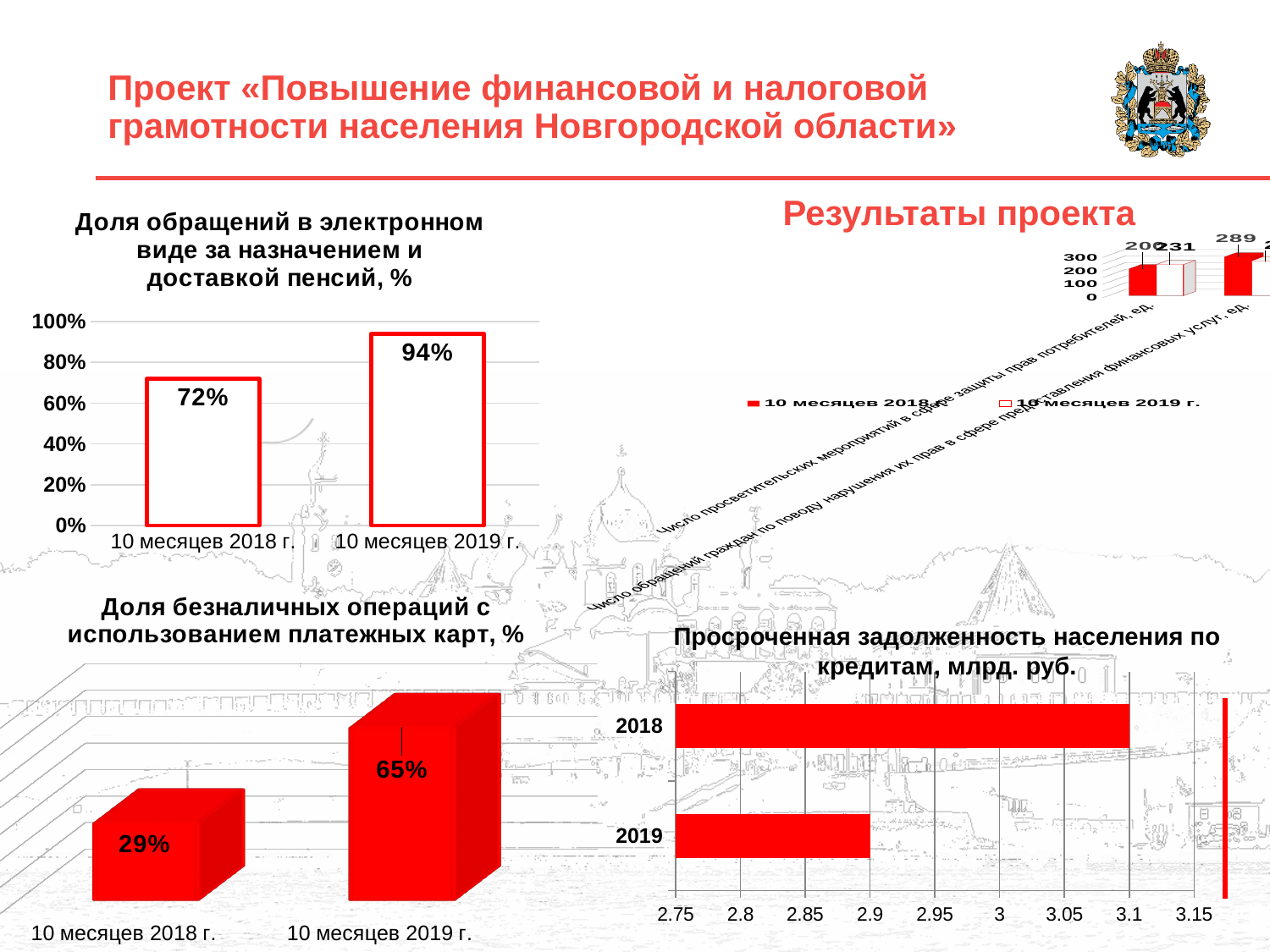
In the chart 'Доля обращений в электронном виде за назначением и доставкой пенсий, %', by how many percentage points did the value increase from 10 месяцев 2018 г. to 10 месяцев 2019 г.? 22 In the chart 'Доля безналичных операций с использованием платежных карт, %', which period has the higher value? 10 месяцев 2019 г. What kind of chart is 'Просроченная задолженность населения по кредитам, млрд. руб.'? bar chart In the chart 'Доля безналичных операций с использованием платежных карт, %', what is the value for 10 месяцев 2019 г.? 65% In the chart 'Доля обращений в электронном виде за назначением и доставкой пенсий, %', what is the value for 10 месяцев 2019 г.? 94% In the chart 'Просроченная задолженность населения по кредитам, млрд. руб.', which year has the larger value, 2018 or 2019? 2018 In the chart 'Просроченная задолженность населения по кредитам, млрд. руб.', is the value for 2018 greater or less than 3? greater In the chart 'Доля безналичных операций с использованием платежных карт, %', what is the value for 10 месяцев 2018 г.? 29% In the chart 'Доля безналичных операций с использованием платежных карт, %', what is the difference between the 2019 and 2018 values? 36 In the chart 'Доля обращений в электронном виде за назначением и доставкой пенсий, %', do the values rise or fall from 2018 to 2019? rise In the chart 'Просроченная задолженность населения по кредитам, млрд. руб.', is the value for 2019 greater or less than 3? less In the chart 'Доля обращений в электронном виде за назначением и доставкой пенсий, %', what is the value for 10 месяцев 2018 г.? 72%